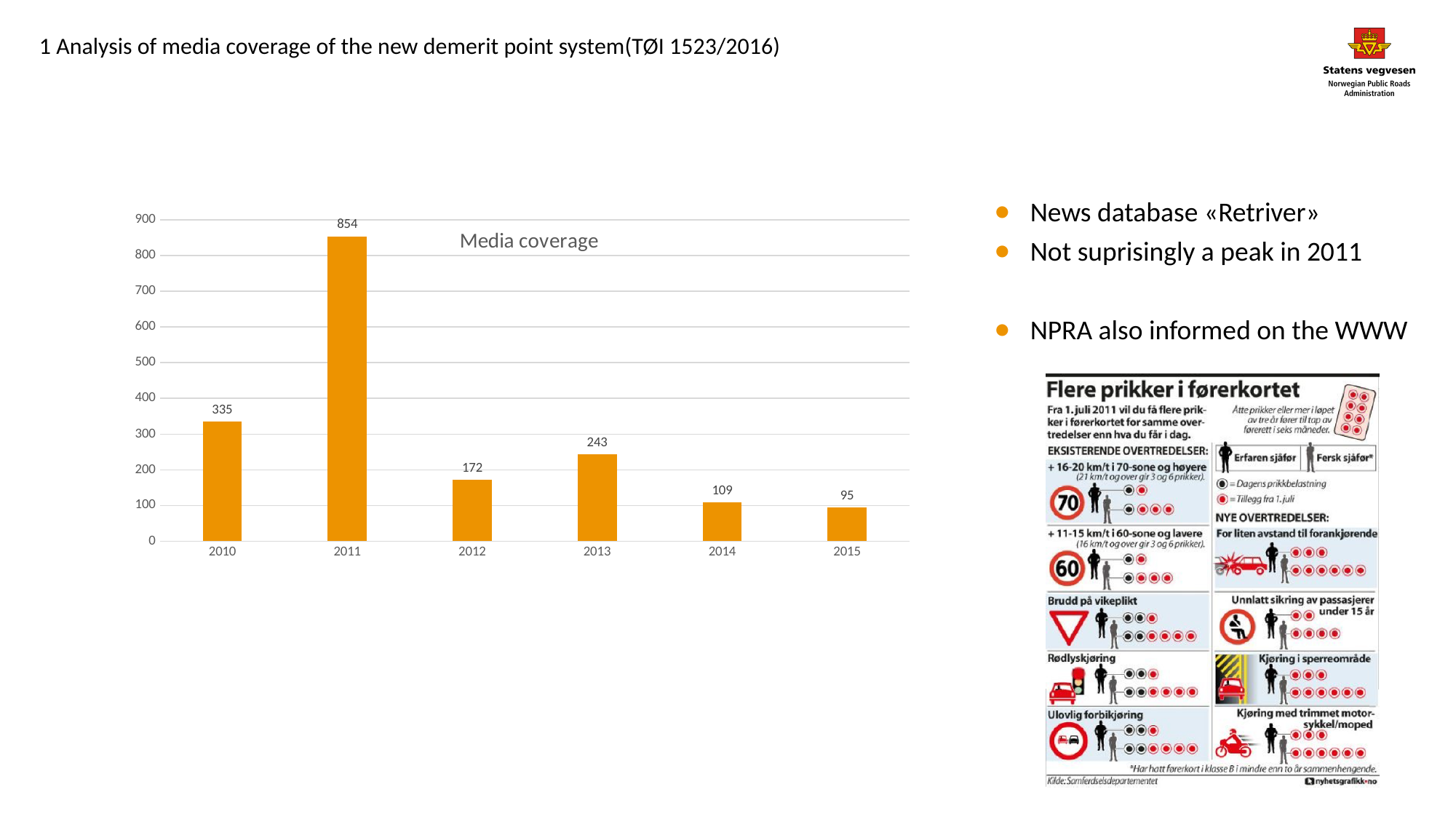
What is the media coverage value for 2013? 243 How many years are shown on the x axis of the chart? 6 Which year has the highest media coverage? 2011 What is the media coverage value for 2015? 95 Is the media coverage value for 2010 greater or less than 300? greater What kind of chart is used to show media coverage? bar chart Which year has the lowest media coverage? 2015 Which year has higher media coverage, 2012 or 2014? 2012 What is the media coverage value for 2011? 854 What is the difference in media coverage between 2013 and 2012? 71 What is the difference in media coverage between 2011 and 2010? 519 What is the title of the chart? Media coverage